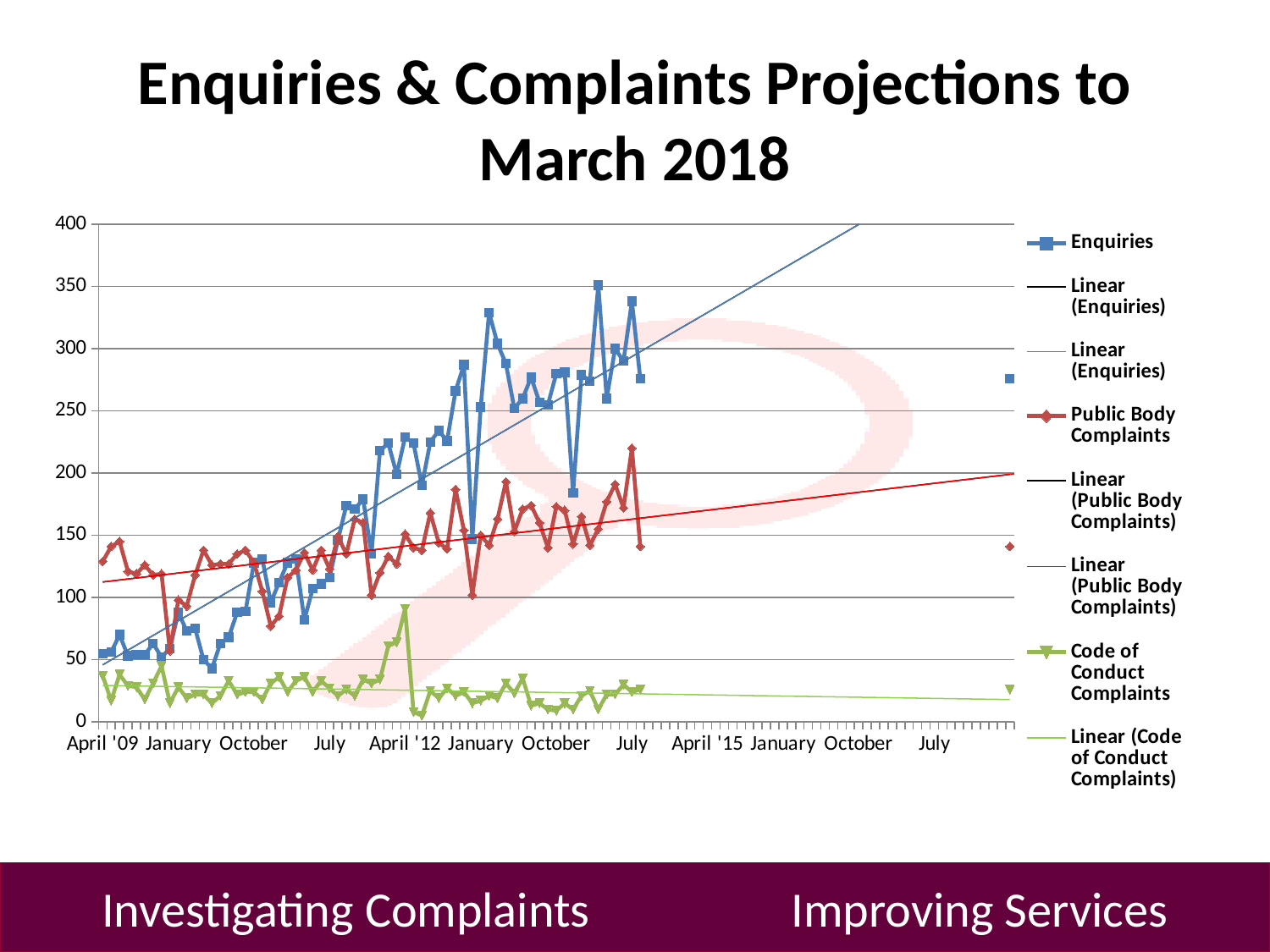
At the last plotted point, which is larger: Enquiries or Public Body Complaints? Enquiries What kind of chart is shown on the slide? line chart What is the title of the chart? Enquiries & Complaints Projections to March 2018 How many entries does the chart legend list? 8 Does the linear trendline for Code of Conduct Complaints rise or fall along the x axis? fall At April '09, which is larger: the Enquiries value or the Public Body Complaints value? Public Body Complaints Is the highest plotted value for Public Body Complaints greater or less than 200? greater Is the highest plotted value for Enquiries greater or less than 300? greater Do the Enquiries values generally rise or fall from April '09 onwards? rise Is the highest plotted value for Code of Conduct Complaints greater or less than 100? less What is the maximum value shown on the vertical axis? 400 Which series has the lowest values throughout the chart? Code of Conduct Complaints